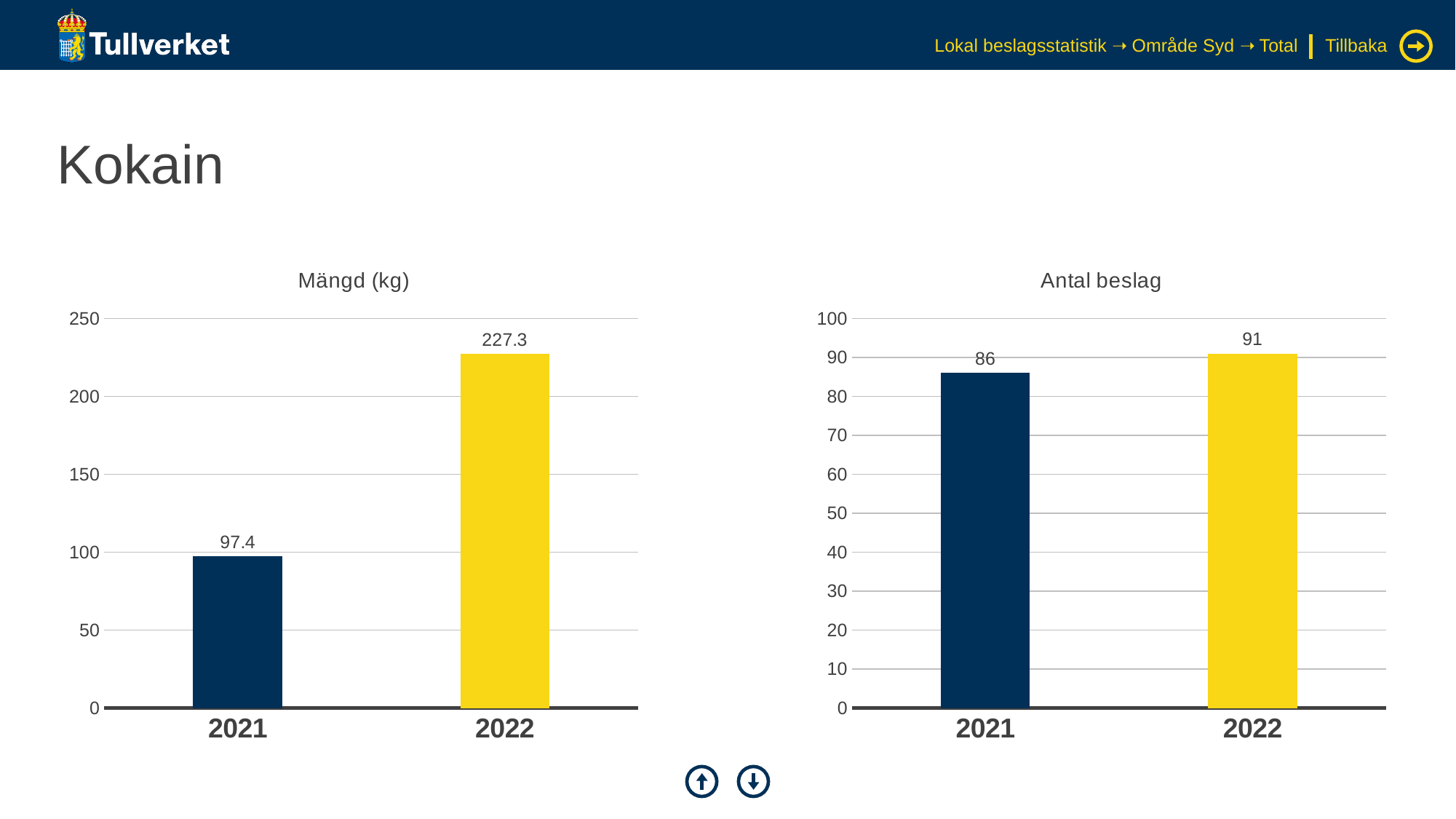
In the 'Mängd (kg)' chart, which year has the highest value? 2022 What kind of chart is the 'Mängd (kg)' chart? bar chart In the 'Mängd (kg)' chart, what is the value for 2021? 97.4 In the 'Mängd (kg)' chart, is the value for 2022 greater or less than 200? greater In the 'Mängd (kg)' chart, what is the value for 2022? 227.3 In the 'Antal beslag' chart, which year has the lowest value? 2021 In the 'Antal beslag' chart, how many years are shown on the x axis? 2 In the 'Antal beslag' chart, what is the value for 2022? 91 In the 'Antal beslag' chart, what is the difference between the 2022 and 2021 values? 5 In the 'Antal beslag' chart, do the values rise or fall from 2021 to 2022? rise In the 'Mängd (kg)' chart, what is the difference between the 2022 and 2021 values? 129.9 In the 'Antal beslag' chart, what is the value for 2021? 86